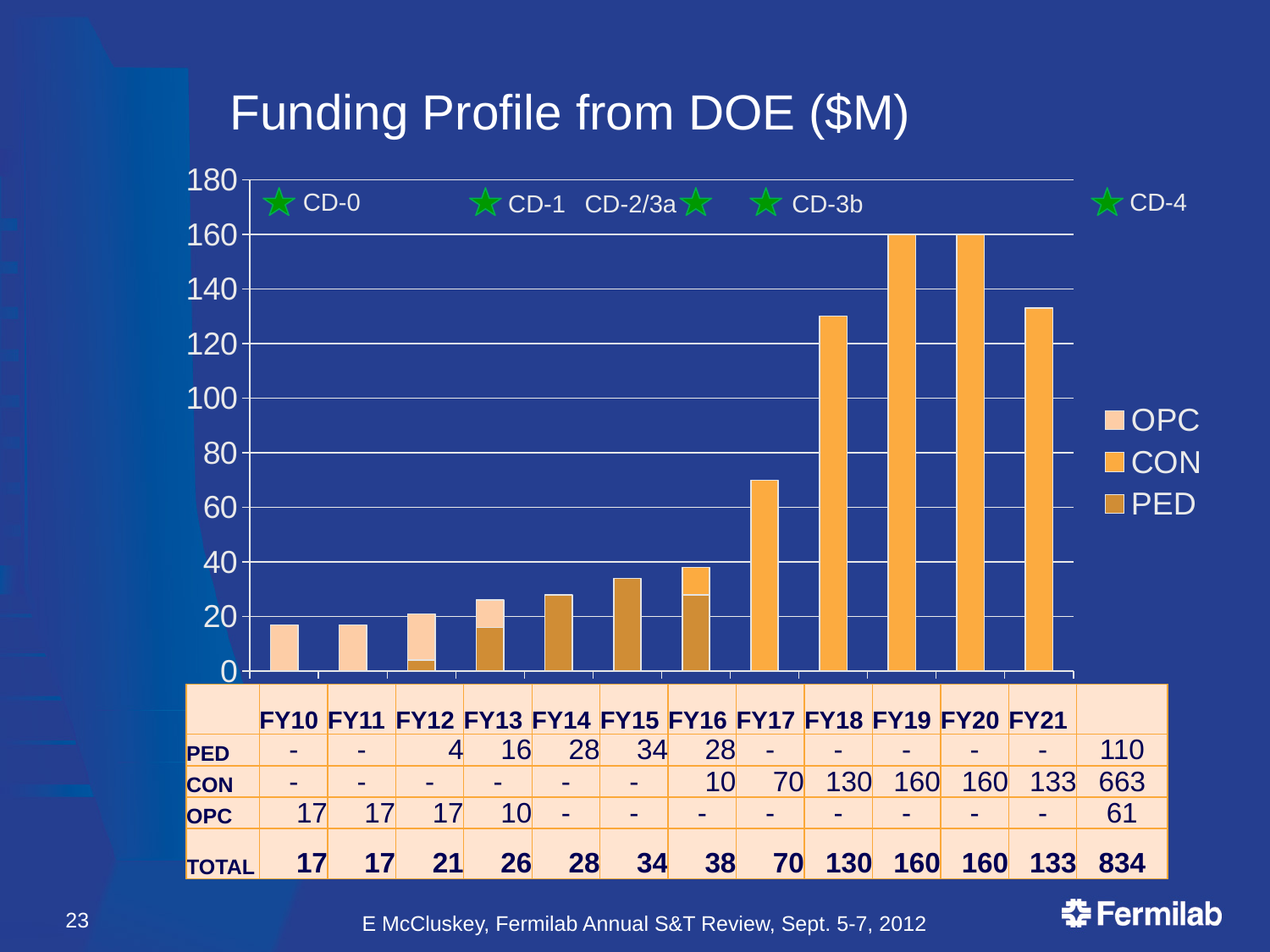
What is the CON value for FY18? 130 What is the title of the chart? Funding Profile from DOE ($M) Is the total for FY17 greater or less than 60? greater Which fiscal year has the highest PED value? FY15 How many series does the legend list? 3 What kind of chart is shown on the slide? bar chart What is the PED value for FY15? 34 Which has the larger total, FY17 or FY21? FY21 What is the difference between the CON values for FY18 and FY17? 60 How many fiscal years are plotted along the x axis? 12 Which fiscal year has the lowest non-zero OPC value? FY13 What is the total funding for FY16? 38